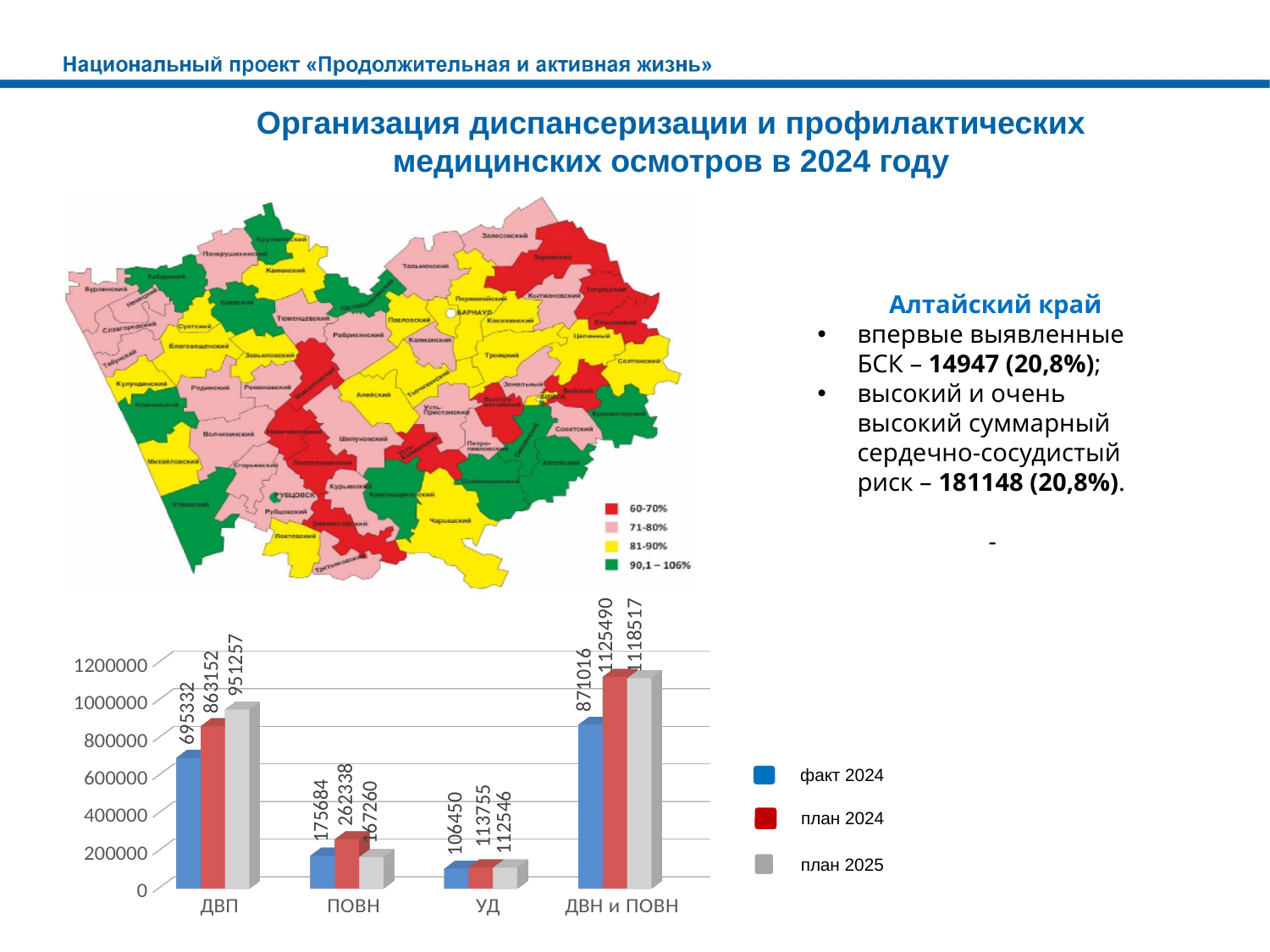
How many series does the legend of the bar chart list? 3 In the bar chart, what is the difference between план 2024 and факт 2024 for ДВП? 167820 In the bar chart, what is the difference between план 2024 and план 2025 for ПОВН? 95078 In the bar chart, which category has the lowest план 2024 value? УД In the bar chart, what is the факт 2024 value for УД? 106450 In the bar chart, what is the факт 2024 value for ДВП? 695332 How many categories are shown on the x axis of the bar chart? 4 What type of chart is shown at the bottom of the slide? bar chart In the bar chart, what is the план 2025 value for ДВН и ПОВН? 1118517 In the bar chart, which category has the highest факт 2024 value? ДВН и ПОВН In the bar chart, which is larger for ПОВН: факт 2024 or план 2025? факт 2024 In the bar chart, what is the план 2024 value for ПОВН? 262338